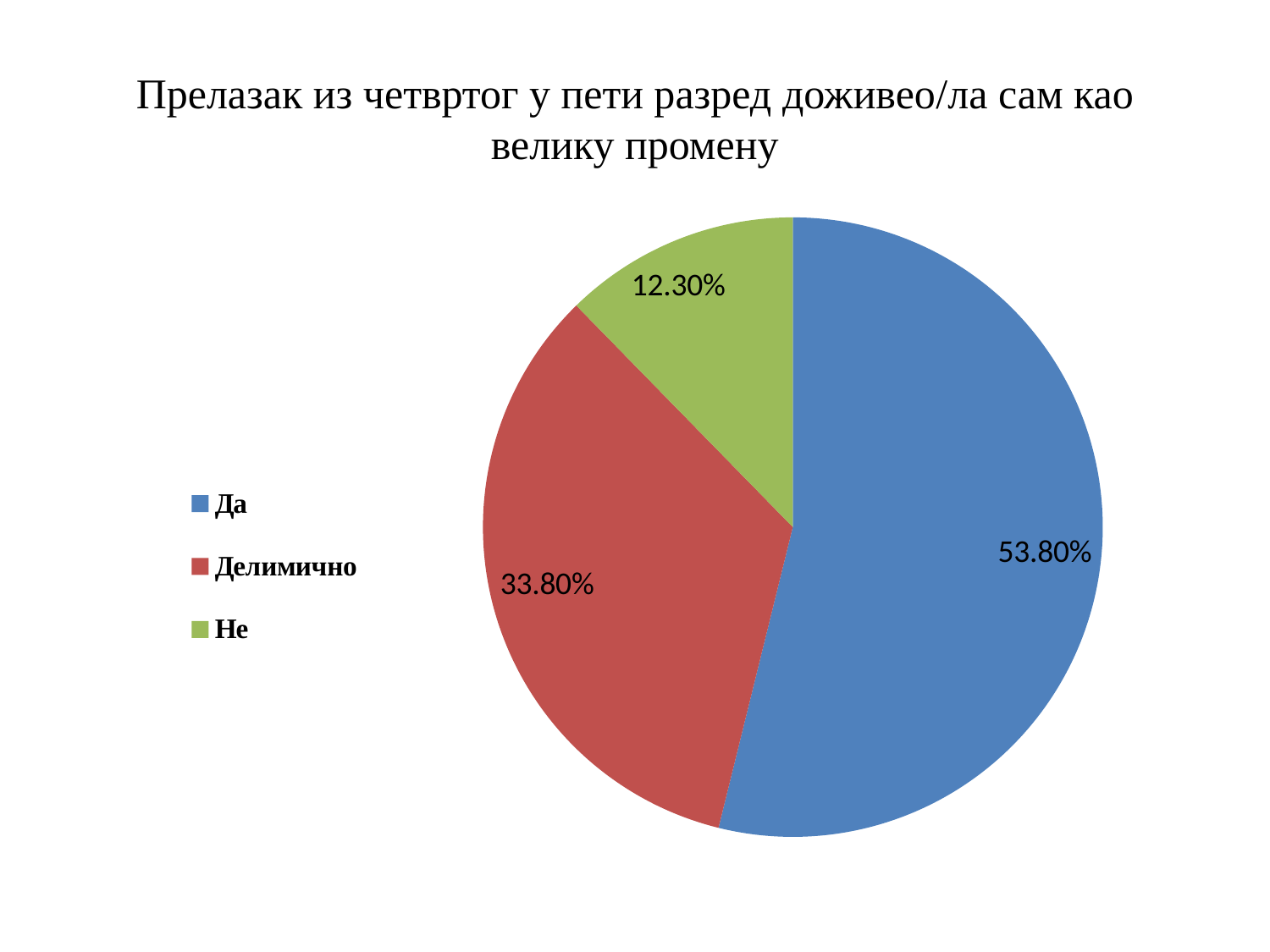
What is the value for Делимично? 33.80% Which is larger, the value for Делимично or the value for Не? Делимично How many slices does the pie chart have? 3 What kind of chart is shown on the slide? pie chart What colour is the slice for Не? green What is the difference between the values for Делимично and Не? 21.50% What is the value for Не? 12.30% What is the difference between the values for Да and Делимично? 20.00% Which category has the smallest share of the pie? Не How many entries does the legend list? 3 Which category has the largest share of the pie? Да What is the value for Да? 53.80%